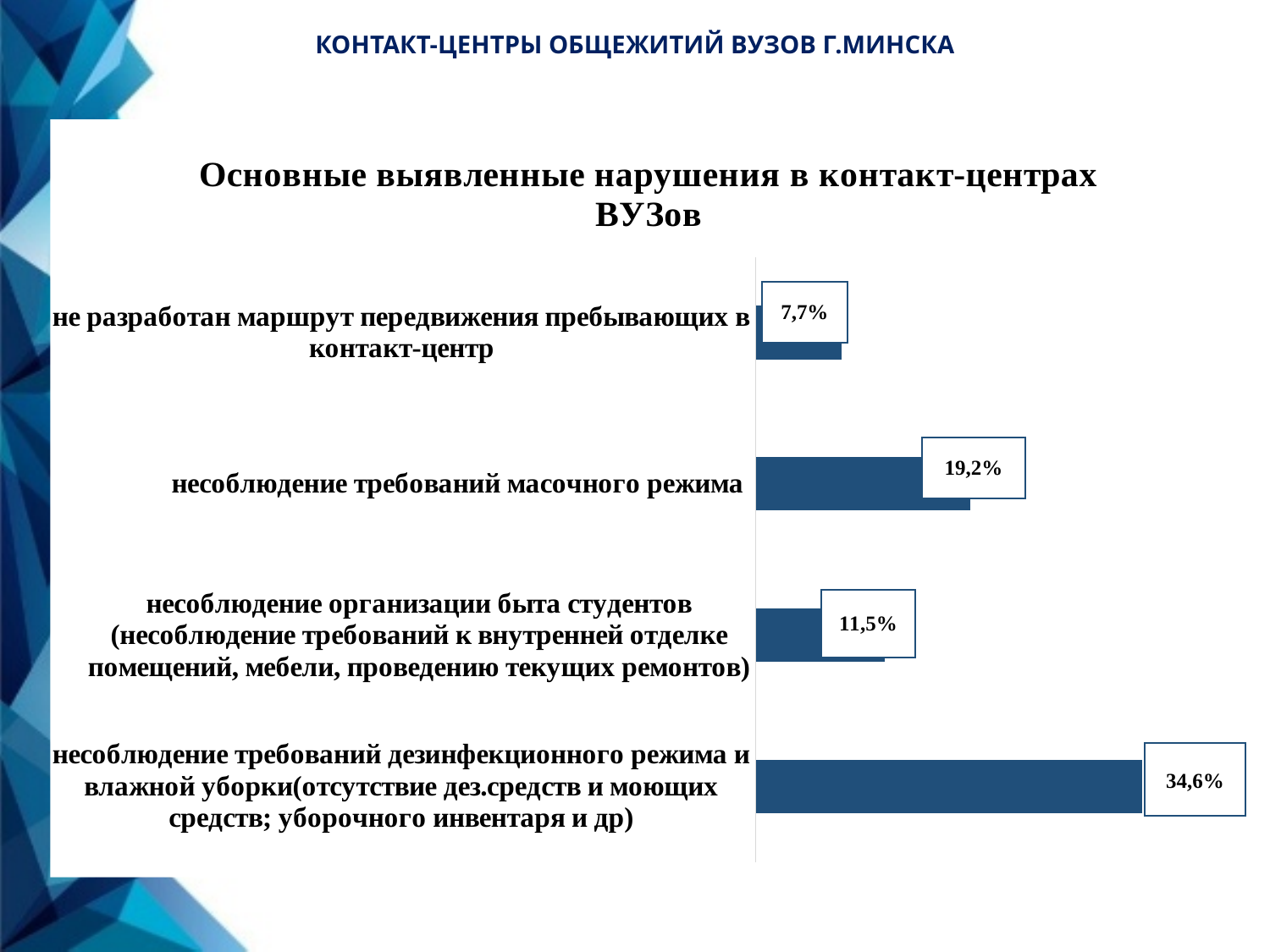
Which category has the highest value? несоблюдение требований дезинфекционного режима и влажной уборки How many categories are shown in the chart? 4 Which category has the lowest value? не разработан маршрут передвижения пребывающих в контакт-центр What is the difference between the values for "несоблюдение организации быта студентов" and "не разработан маршрут передвижения пребывающих в контакт-центр"? 3,8% What is the difference between the values for "несоблюдение требований дезинфекционного режима и влажной уборки" and "несоблюдение требований масочного режима"? 15,4% What is the value for "не разработан маршрут передвижения пребывающих в контакт-центр"? 7,7% Which is larger: the value for "несоблюдение требований масочного режима" or for "несоблюдение организации быта студентов"? несоблюдение требований масочного режима What is the value for "несоблюдение требований масочного режима"? 19,2% What is the value for "несоблюдение организации быта студентов"? 11,5% What is the value for "несоблюдение требований дезинфекционного режима и влажной уборки"? 34,6% What is the title of the chart? Основные выявленные нарушения в контакт-центрах ВУЗов What kind of chart is shown on the slide? bar chart